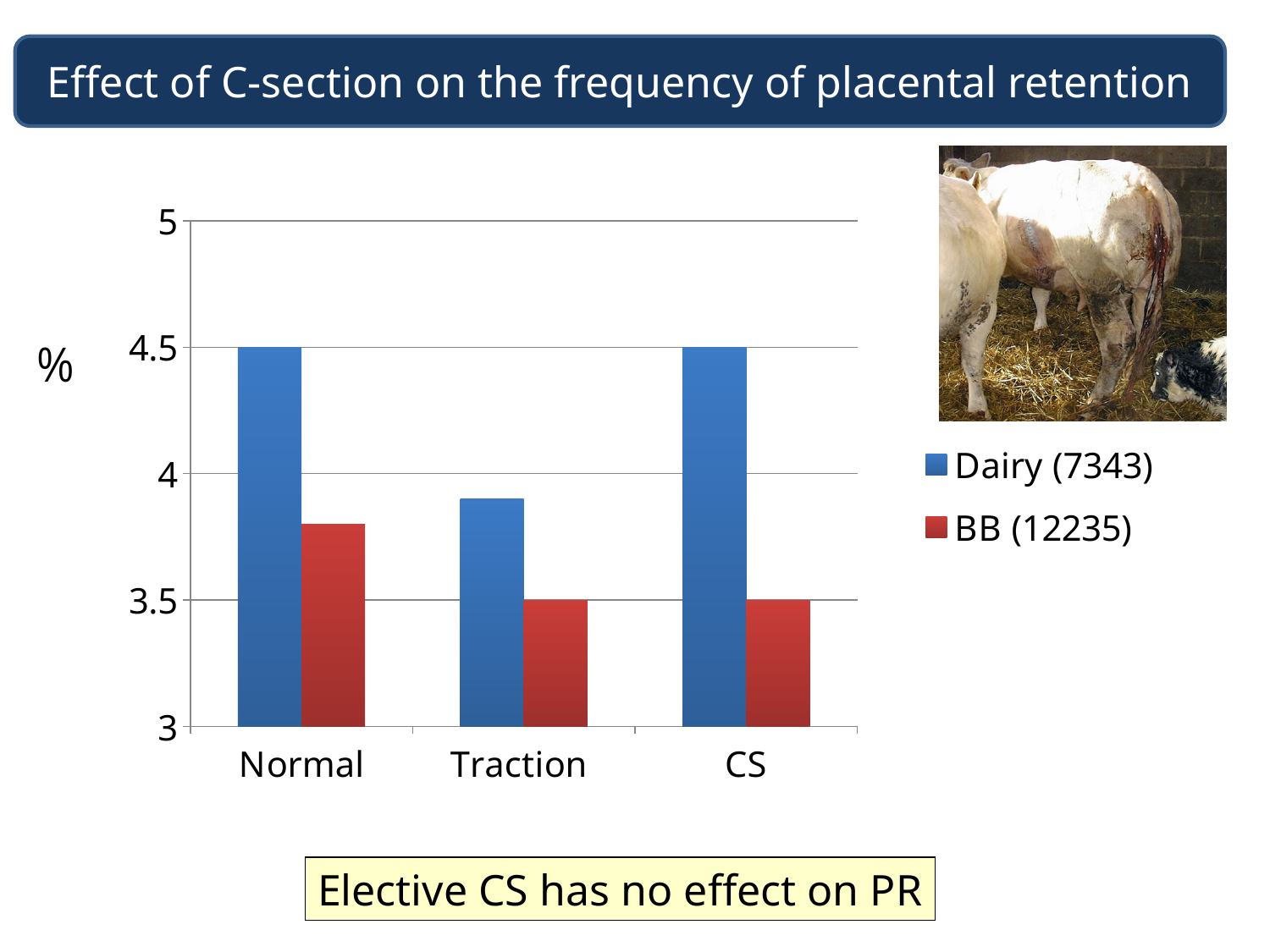
What is the value for BB (12235) in the Traction category? 3.5 How many categories are shown on the x axis? 3 What is the value for Dairy (7343) in the Normal category? 4.5 What is the value for BB (12235) in the CS category? 3.5 Is the value for Dairy (7343) in the Traction category greater or less than 4? less How many series does the legend list? 2 What is the value for Dairy (7343) in the CS category? 4.5 Is the value for BB (12235) in the Normal category greater or less than 3.5? greater In which category is the Dairy (7343) value lowest? Traction In which category is the BB (12235) value highest? Normal What is the difference between the Dairy (7343) and BB (12235) values in the CS category? 1 What type of chart is shown on the slide? bar chart